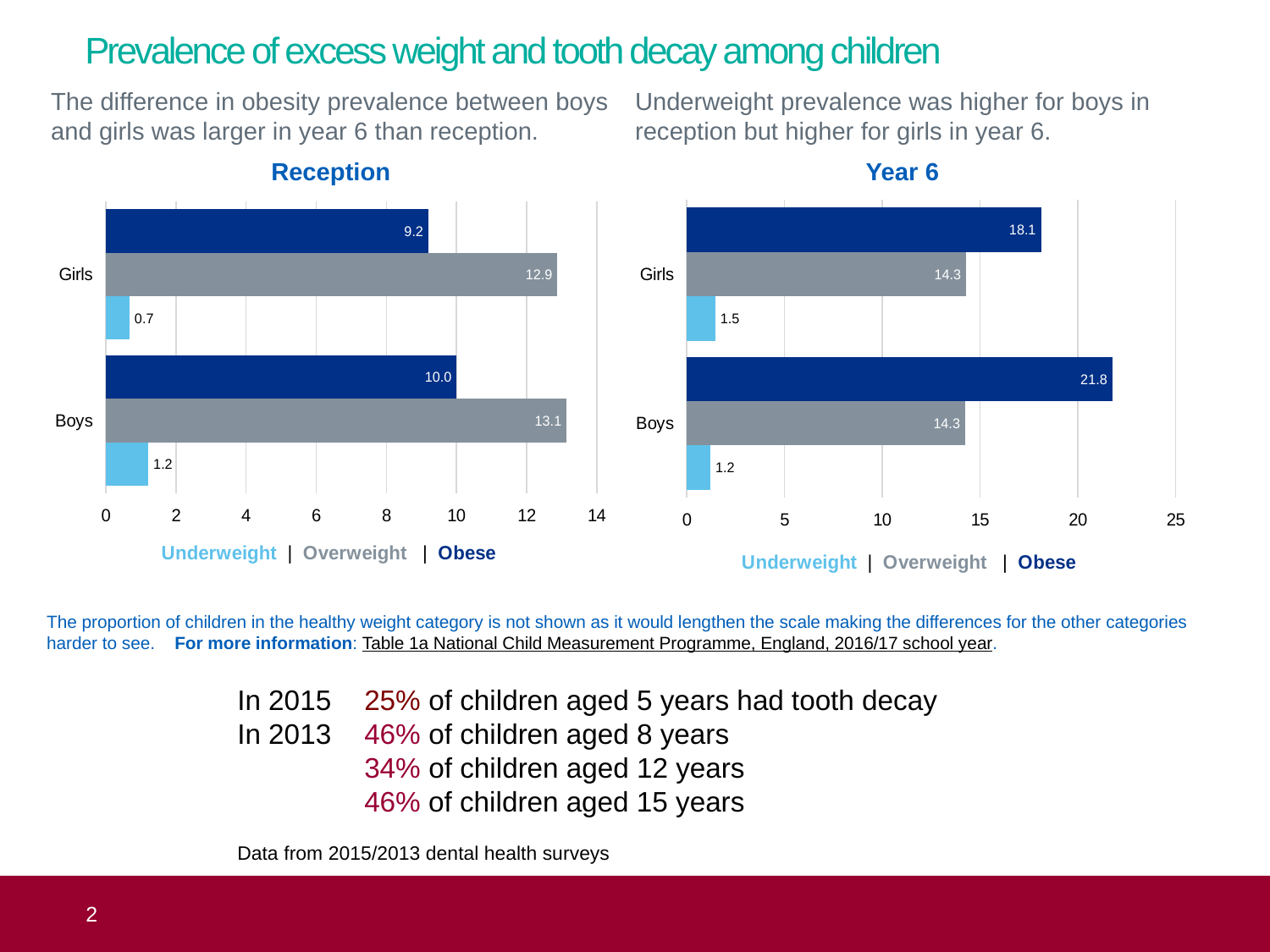
In the Year 6 chart, which group has the higher Obese value, Girls or Boys? Boys In the Reception chart, what is the Overweight value for Girls? 12.9 In the Reception chart, what is the Underweight value for Boys? 1.2 In the Year 6 chart, which bar has the highest value? Boys Obese (21.8) In the Reception chart, which bar has the lowest value? Girls Underweight (0.7) In the Year 6 chart, what is the difference between the Obese values for Boys and Girls? 3.7 In the Year 6 chart, is the Overweight value for Girls greater or less than 15? less In the Year 6 chart, what is the Underweight value for Girls? 1.5 In the Year 6 chart, what is the Obese value for Boys? 21.8 What type of chart is the Year 6 chart? Bar chart In the Reception chart, what is the difference between the Obese values for Boys and Girls? 0.8 How many series does the legend of the Reception chart list? 3